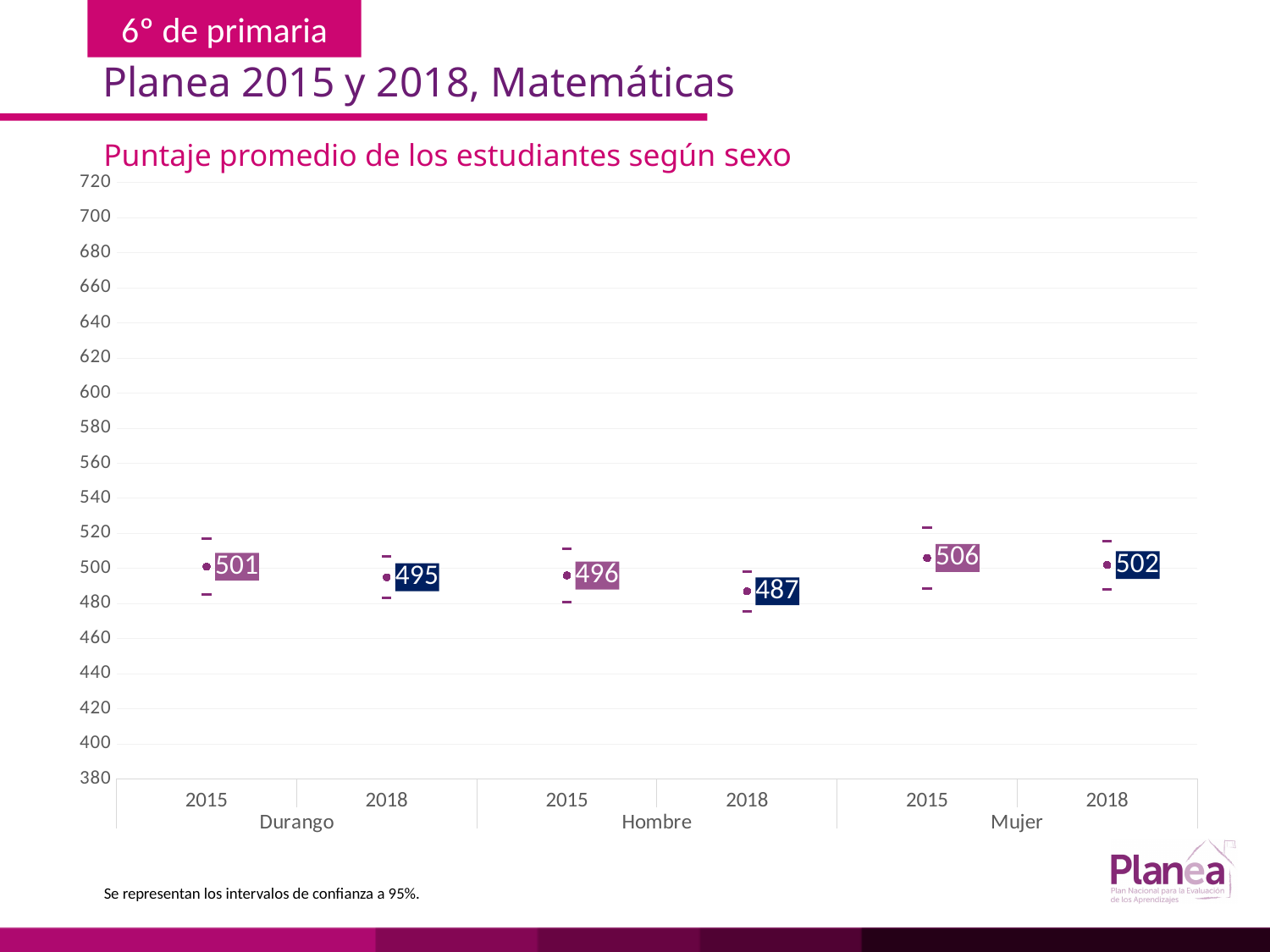
Which group and year has the lowest average score? Hombre 2018 Did the Hombre score rise or fall from 2015 to 2018? fall How many data points are plotted in the chart? 6 What is the difference between the Mujer and Hombre scores in 2018? 15 What is the average score for Durango in 2015? 501 What is the average score for Mujer in 2015? 506 What is the difference between the Durango scores in 2015 and 2018? 6 Which is larger, the Hombre score in 2015 or the Mujer score in 2015? Mujer 2015 What is the title of the chart? Puntaje promedio de los estudiantes según sexo What is the average score for Hombre in 2018? 487 What is the average score for Mujer in 2018? 502 Which group and year has the highest average score? Mujer 2015